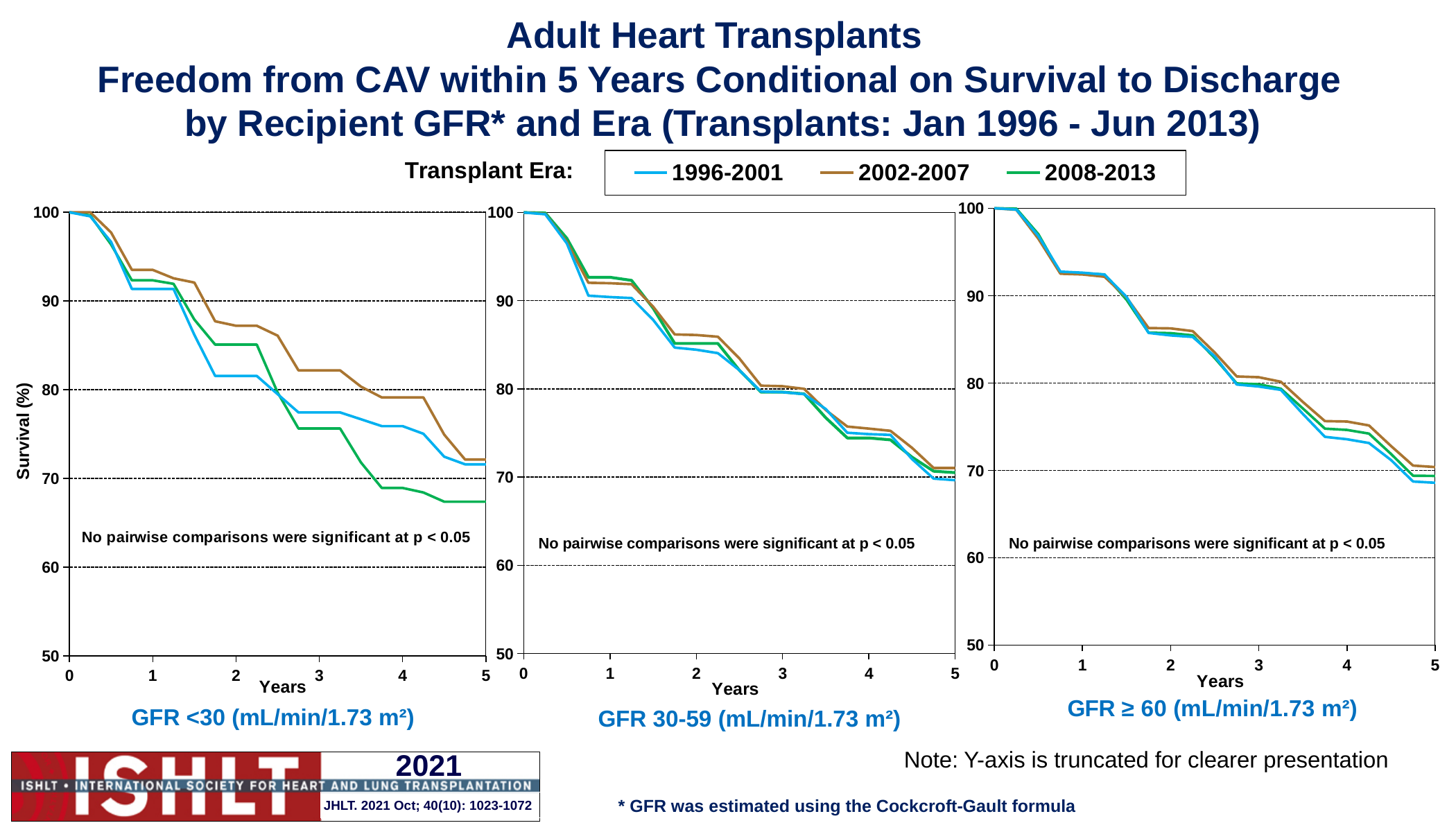
In the GFR <30 (mL/min/1.73 m²) chart, is the value for 2002-2007 at year 1 greater or less than 90? greater What kind of chart is used for each of the three GFR panels? Line chart What is the label on the y-axis of the GFR <30 (mL/min/1.73 m²) chart? Survival (%) In the GFR <30 (mL/min/1.73 m²) chart, is the value for 2008-2013 at year 3 greater or less than 80? less In the GFR ≥ 60 (mL/min/1.73 m²) chart, is the value for 2002-2007 at year 4 greater or less than 80? less How many charts are shown on the slide? 3 How many transplant eras does the legend list? 3 In the GFR <30 (mL/min/1.73 m²) chart, which transplant era has the highest freedom from CAV at year 3? 2002-2007 In the GFR <30 (mL/min/1.73 m²) chart, do the survival curves rise or fall as years increase? Fall In the GFR <30 (mL/min/1.73 m²) chart, which transplant era has the lowest freedom from CAV at year 5? 2008-2013